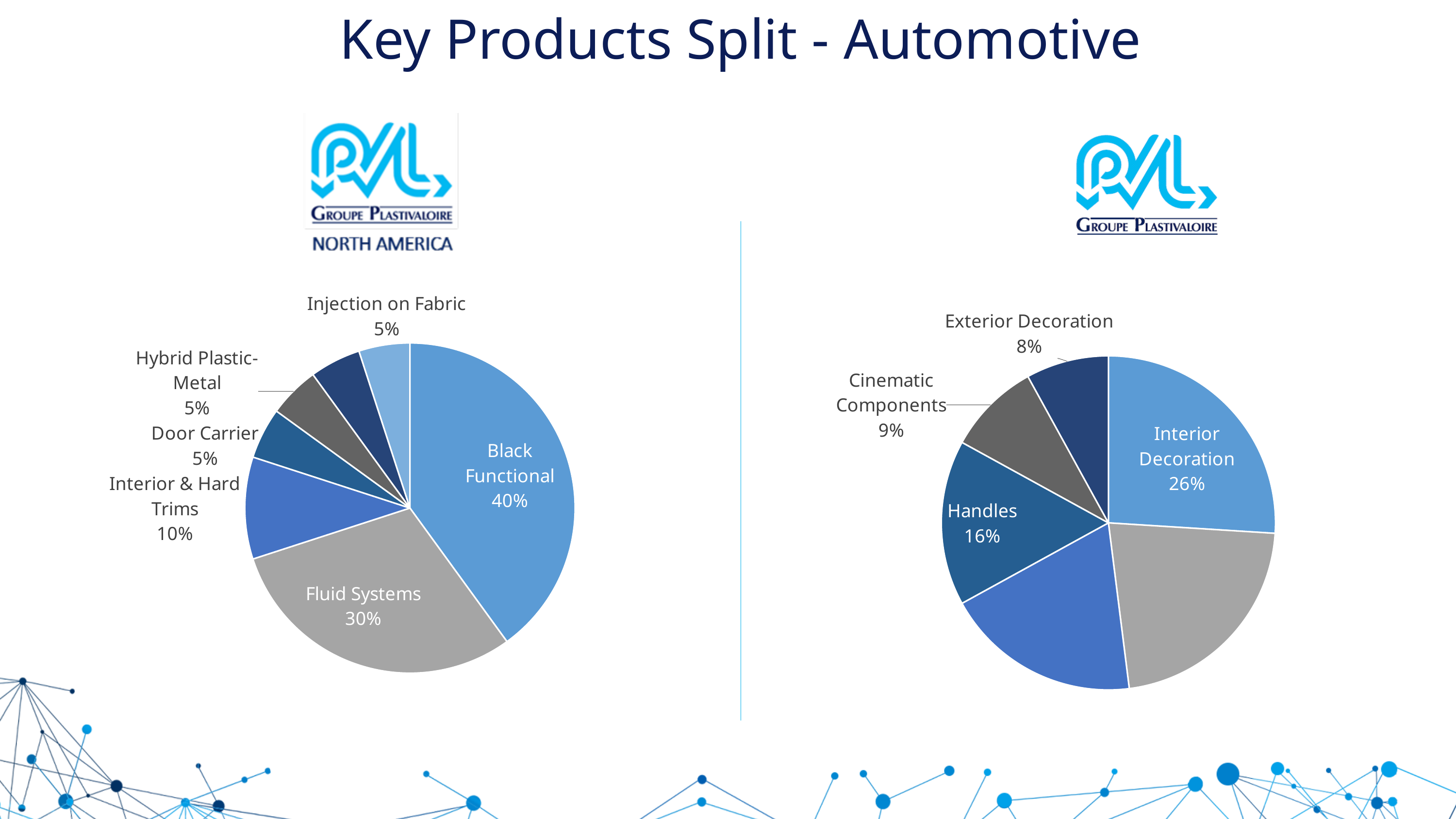
In the left pie chart, which category has the largest share? Black Functional In the right pie chart, what share does Handles have? 16% In the left pie chart, what is the difference between the shares of Black Functional and Fluid Systems? 10% In the left pie chart, how many slices does the pie have? 7 In the right pie chart, what share does Interior Decoration have? 26% In the left pie chart, what share does Fluid Systems have? 30% What kind of chart is the left chart on the slide? pie chart In the left pie chart, what share does Black Functional have? 40% In the left pie chart, which is larger: Interior & Hard Trims or Door Carrier? Interior & Hard Trims In the right pie chart, what share does Cinematic Components have? 9% In the right pie chart, what is the difference between the shares of Interior Decoration and Exterior Decoration? 18% In the left pie chart, what share does Interior & Hard Trims have? 10%